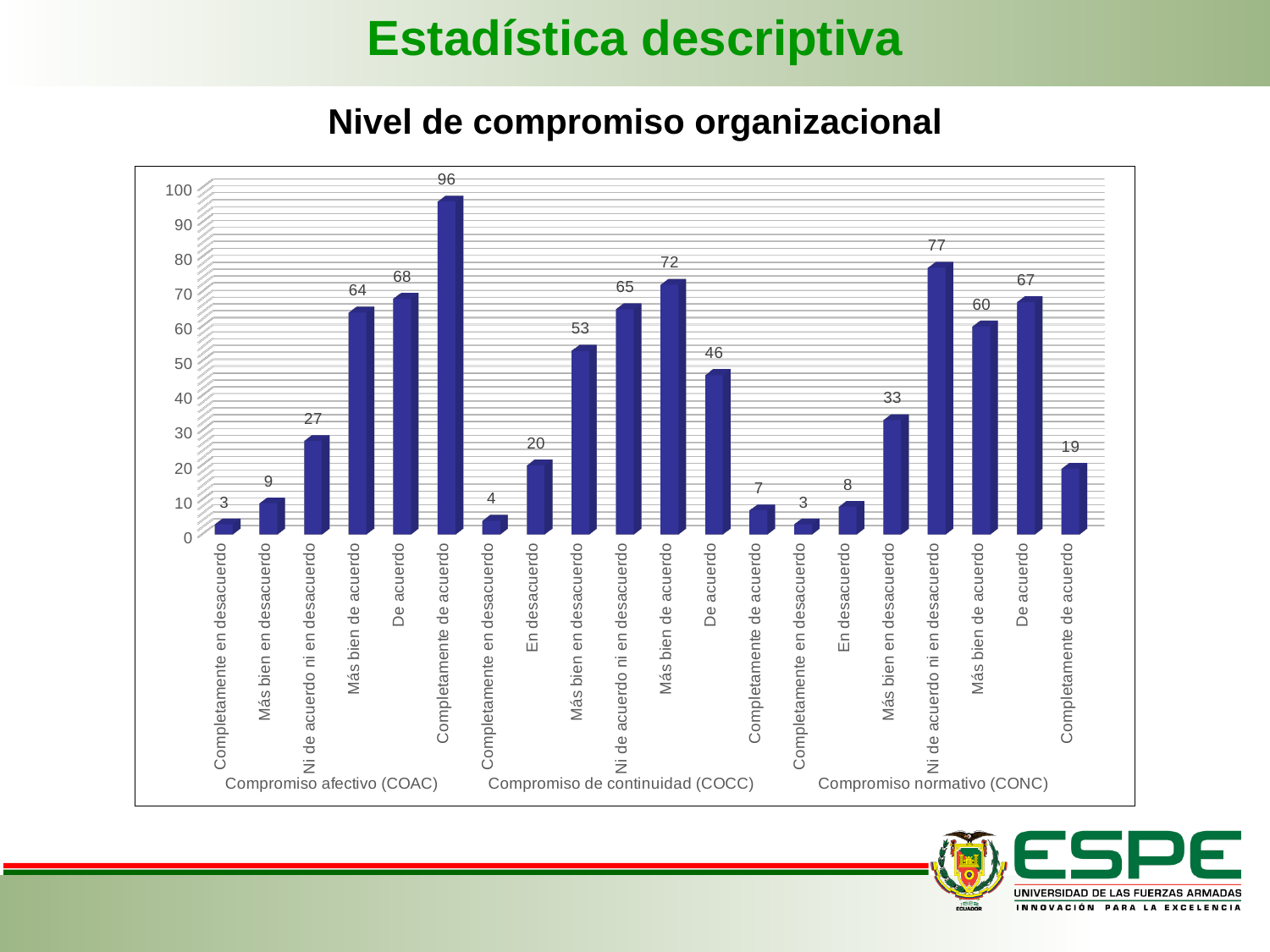
Which is larger: "De acuerdo" in the COCC group or "De acuerdo" in the CONC group? De acuerdo in the CONC group What is the difference between "Ni de acuerdo ni en desacuerdo" in CONC (77) and in COCC (65)? 12 What is the value for "Más bien de acuerdo" in the Compromiso de continuidad (COCC) group? 72 What is the value for "Ni de acuerdo ni en desacuerdo" in the Compromiso normativo (CONC) group? 77 Which bar has the highest value in the whole chart? Completamente de acuerdo (Compromiso afectivo, COAC) What type of chart is shown on the slide? Bar chart What is the difference between "De acuerdo" (68) and "Más bien de acuerdo" (64) in the Compromiso afectivo (COAC) group? 4 How many bars are plotted in the chart in total? 20 What is the value for "Completamente de acuerdo" in the Compromiso afectivo (COAC) group? 96 What is the title of the chart? Nivel de compromiso organizacional Which category has the lowest value within the Compromiso normativo (CONC) group? Completamente en desacuerdo What is the value for "En desacuerdo" in the Compromiso de continuidad (COCC) group? 20